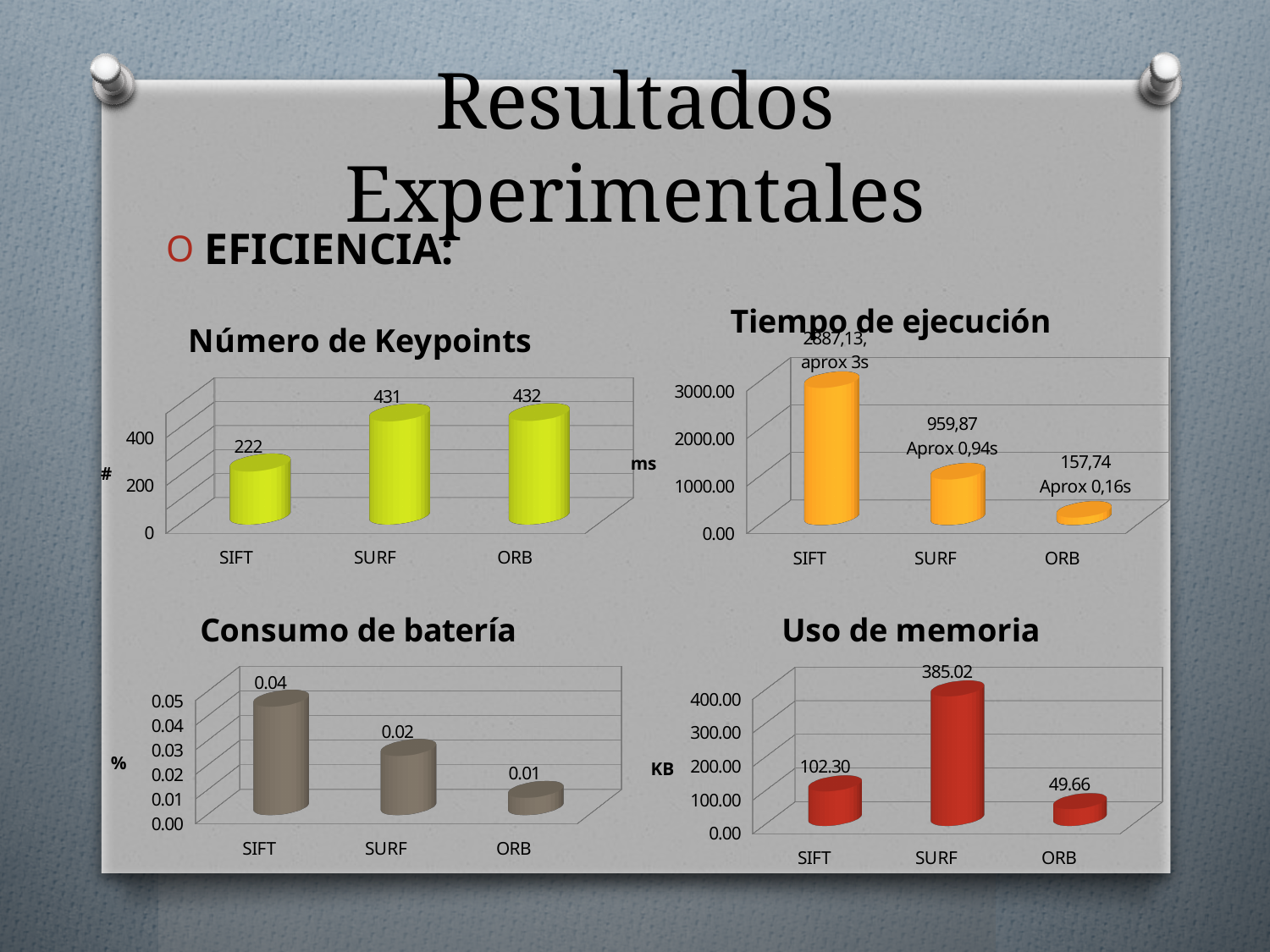
In the 'Uso de memoria' chart, which is larger, the value for SIFT or the value for ORB? SIFT What kind of chart is the 'Uso de memoria' chart? Bar chart In the 'Consumo de batería' chart, what is the value for ORB? 0.01 In the 'Tiempo de ejecución' chart, what is the value for SURF? 959,87 In the 'Número de Keypoints' chart, what is the value for SIFT? 222 In the 'Consumo de batería' chart, what is the difference between the values for SIFT and SURF? 0.02 In the 'Uso de memoria' chart, what is the value for SURF? 385.02 In the 'Tiempo de ejecución' chart, which category has the highest value? SIFT In the 'Número de Keypoints' chart, which category has the lowest value? SIFT How many categories are shown in the 'Consumo de batería' chart? 3 In the 'Uso de memoria' chart, which category has the lowest value? ORB In the 'Tiempo de ejecución' chart, is the value for SIFT greater or less than 2000.00? greater